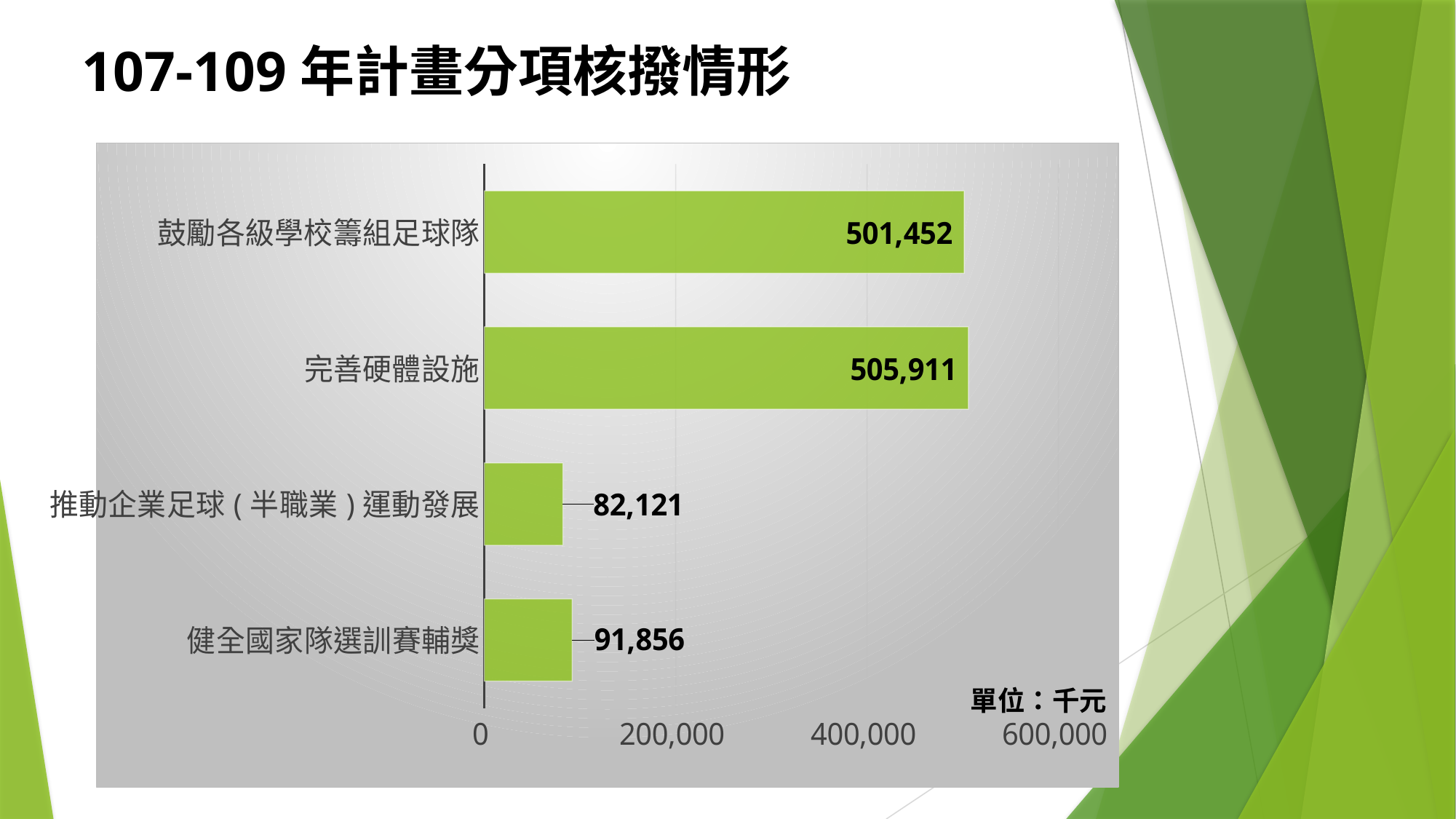
What is the difference between the values for 完善硬體設施 and 鼓勵各級學校籌組足球隊? 4,459 Which category has the lowest value? 推動企業足球（半職業）運動發展 What is the difference between the values for 健全國家隊選訓賽輔獎 and 推動企業足球（半職業）運動發展? 9,735 What is the value for 完善硬體設施? 505,911 Which category has the highest value? 完善硬體設施 What is the value for 鼓勵各級學校籌組足球隊? 501,452 What is the value for 推動企業足球（半職業）運動發展? 82,121 What kind of chart is shown on the slide? bar chart Is the value for 鼓勵各級學校籌組足球隊 greater or less than 400,000? greater What is the value for 健全國家隊選訓賽輔獎? 91,856 How many categories are shown in the chart? 4 Which is larger, the value for 健全國家隊選訓賽輔獎 or the value for 推動企業足球（半職業）運動發展? 健全國家隊選訓賽輔獎